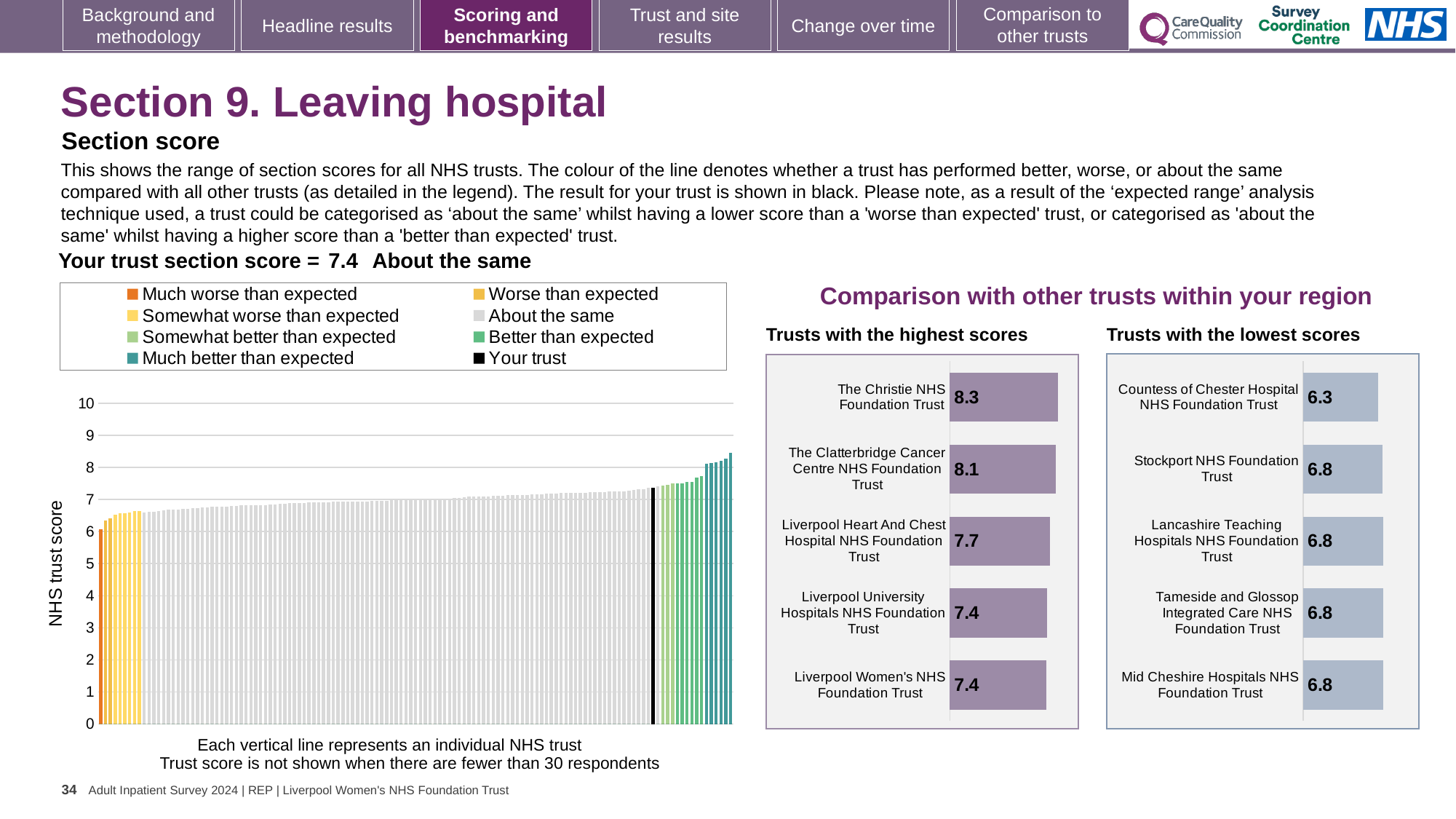
In the 'Trusts with the highest scores' chart, what is the difference between the scores of The Christie NHS Foundation Trust and Liverpool Heart And Chest Hospital NHS Foundation Trust? 0.6 How many entries does the legend above the left-hand chart list? 8 In the 'Trusts with the lowest scores' chart, what is the score for Stockport NHS Foundation Trust? 6.8 In the 'Trusts with the lowest scores' chart, which has the larger score: Countess of Chester Hospital NHS Foundation Trust or Mid Cheshire Hospitals NHS Foundation Trust? Mid Cheshire Hospitals NHS Foundation Trust What kind of chart is the large chart on the left showing NHS trust scores? bar chart In the 'Trusts with the highest scores' chart, how many trusts are shown? 5 In the 'Trusts with the lowest scores' chart, which trust has the lowest score? Countess of Chester Hospital NHS Foundation Trust In the left-hand chart, do the trust scores rise or fall from left to right? rise In the left-hand chart, is the value of the tallest bar greater or less than 8? greater In the 'Trusts with the highest scores' chart, which trust has the highest score? The Christie NHS Foundation Trust What is the label on the vertical axis of the left-hand chart? NHS trust score In the 'Trusts with the highest scores' chart, what is the score for Liverpool Heart And Chest Hospital NHS Foundation Trust? 7.7